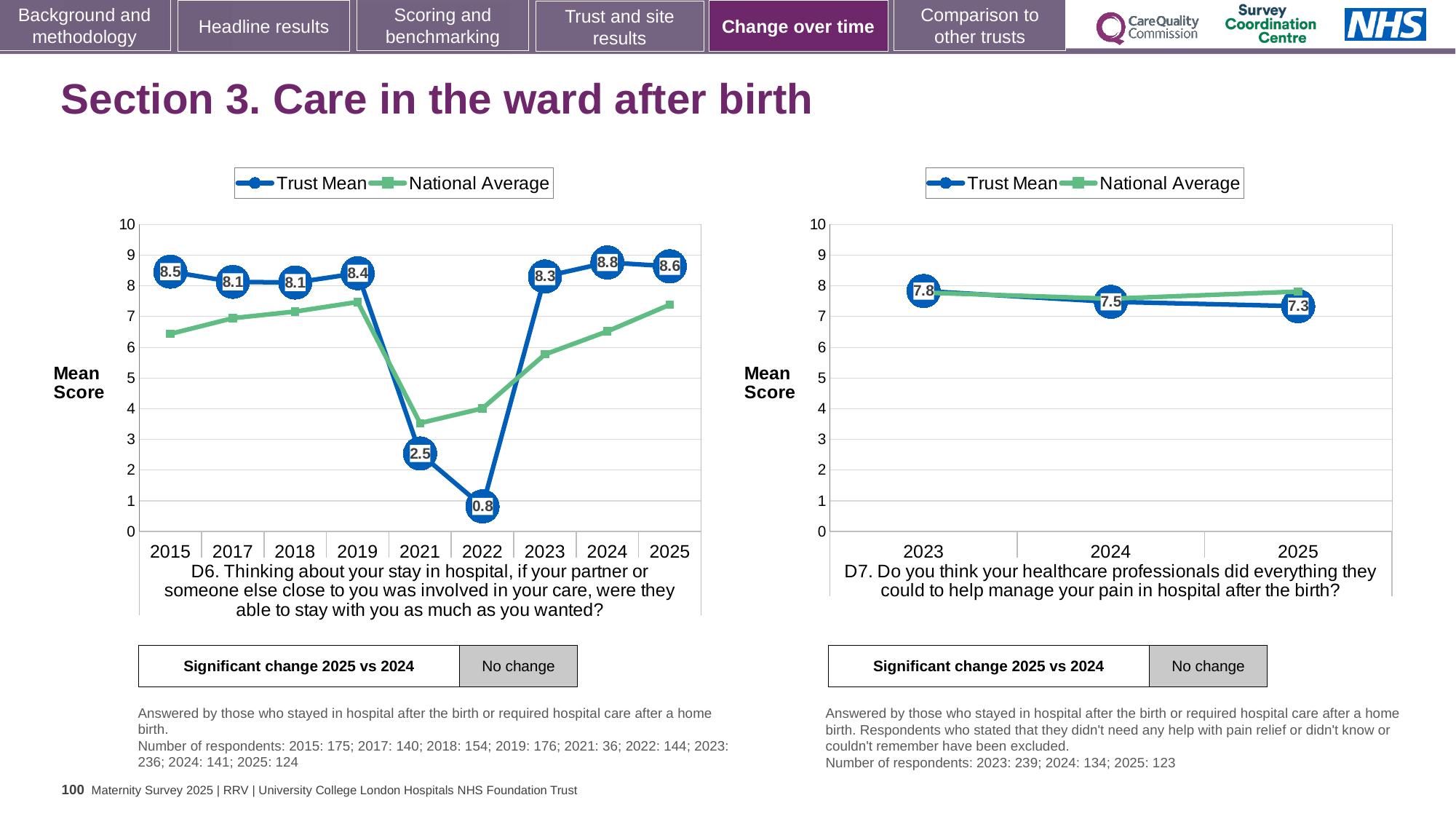
How many series does the legend of the right chart (D7) list? 2 What type of chart is the left chart (D6)? line chart In the right chart (D7), what is the Trust Mean for 2025? 7.3 In the left chart (D6), is the National Average for 2021 greater or less than 4? less In the right chart (D7), does the Trust Mean rise or fall from 2023 to 2025? fall In the left chart (D6), what is the difference between the Trust Mean in 2024 and in 2025? 0.2 In the left chart (D6), how many years are shown on the x axis? 9 In the left chart (D6), what is the Trust Mean for 2022? 0.8 In the left chart (D6), which year has the highest Trust Mean? 2024 In the left chart (D6), what is the Trust Mean for 2024? 8.8 In the right chart (D7), what is the difference between the Trust Mean in 2023 and in 2025? 0.5 In the left chart (D6), which year has the lowest Trust Mean? 2022